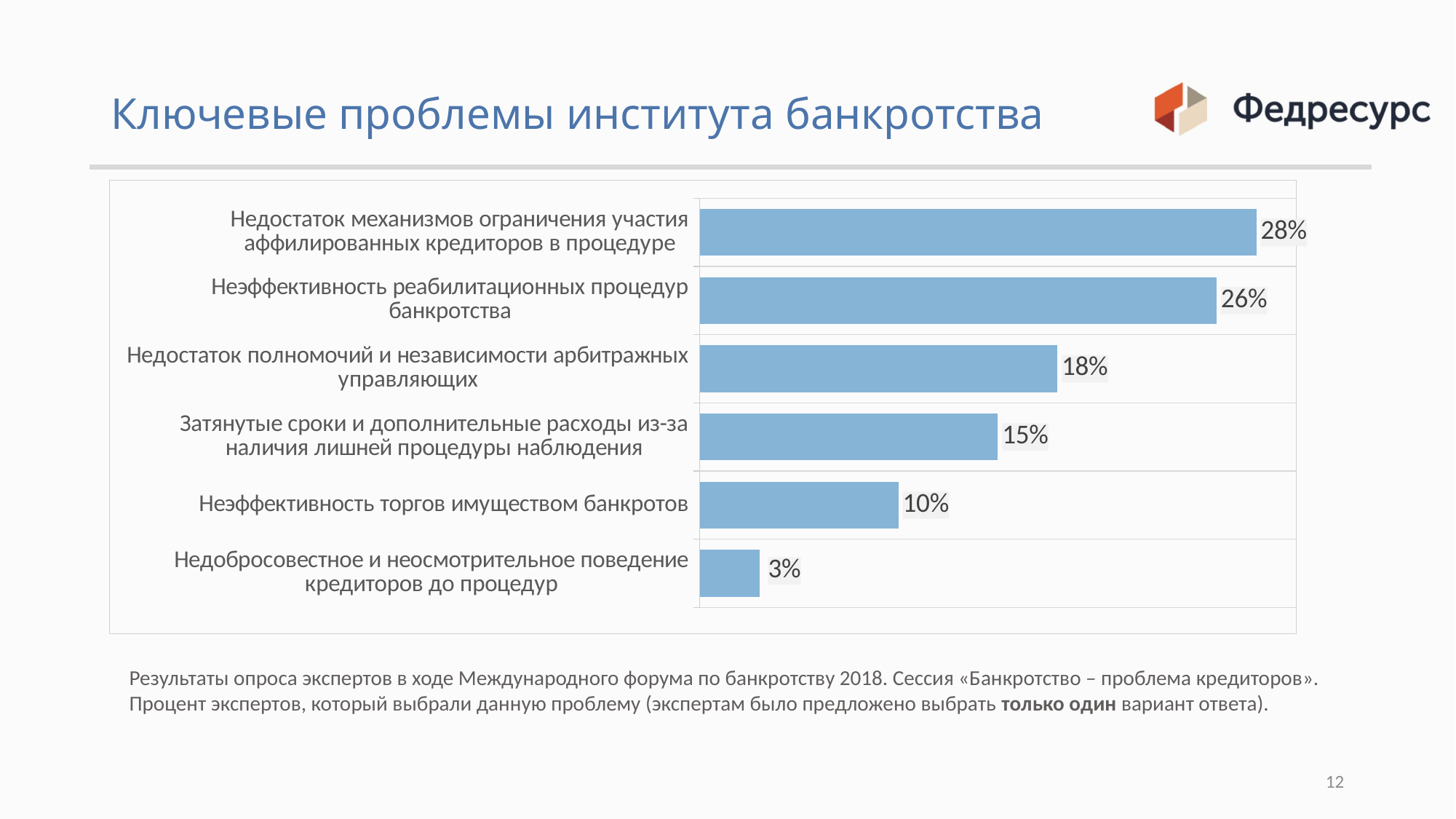
What percentage of experts chose «Недостаток механизмов ограничения участия аффилированных кредиторов в процедуре»? 28% What kind of chart is shown on the slide? Bar chart What value is shown for «Затянутые сроки и дополнительные расходы из-за наличия лишней процедуры наблюдения»? 15% What colour are the bars in the chart? Blue Which is larger: the value for «Недостаток полномочий и независимости арбитражных управляющих» or for «Неэффективность торгов имуществом банкротов»? Недостаток полномочий и независимости арбитражных управляющих What is the title of the slide? Ключевые проблемы института банкротства What is the difference between the highest and lowest values in the chart? 25% How many problems (categories) are shown in the chart? 6 Which problem has the lowest share of experts? Недобросовестное и неосмотрительное поведение кредиторов до процедур What is the difference between the values for «Неэффективность реабилитационных процедур банкротства» and «Недостаток полномочий и независимости арбитражных управляющих»? 8% Which problem has the highest share of experts? Недостаток механизмов ограничения участия аффилированных кредиторов в процедуре What value is shown for «Неэффективность торгов имуществом банкротов»? 10%